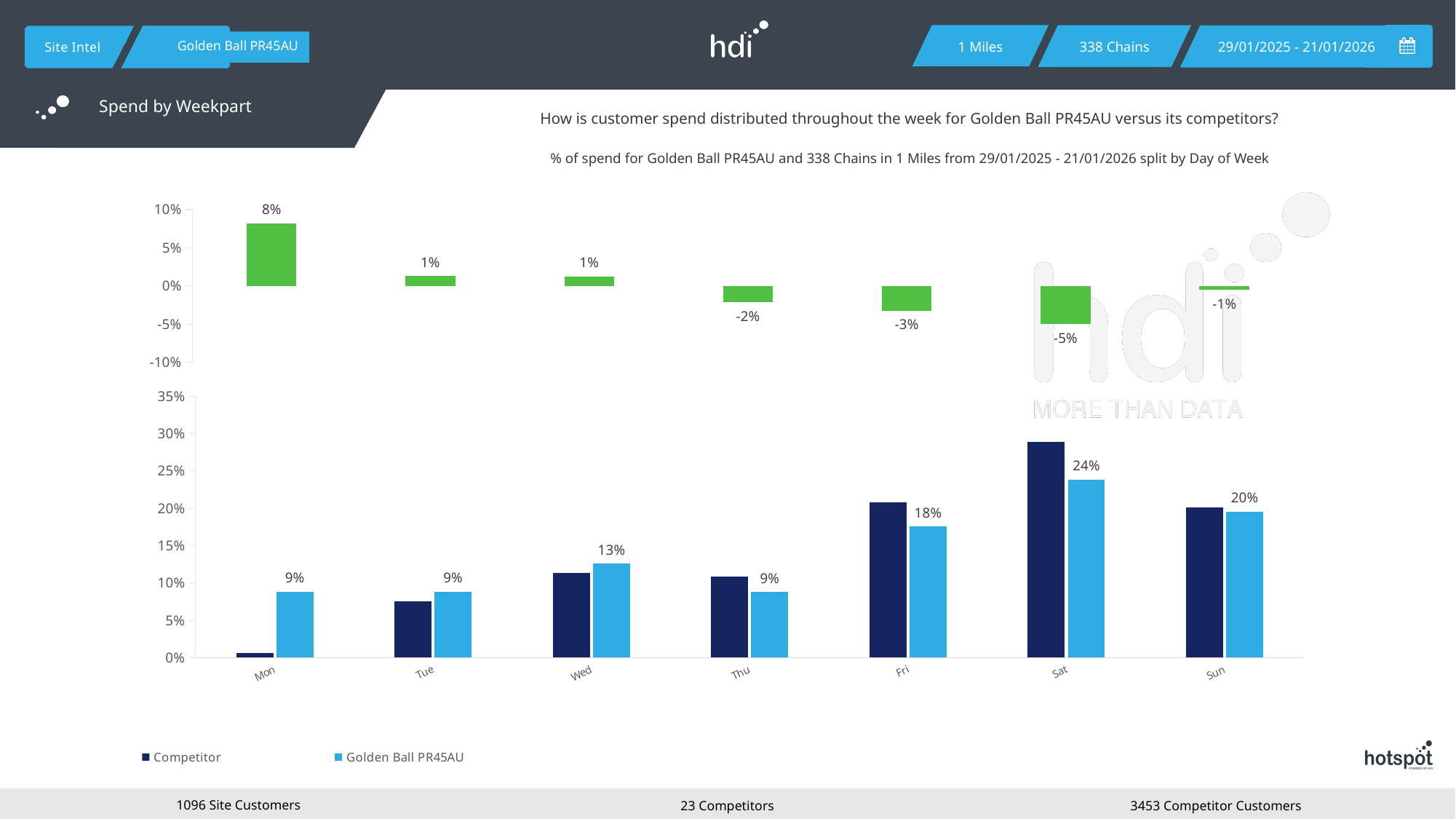
In the bottom chart, which is larger on Mon: the Competitor bar or the Golden Ball PR45AU bar? Golden Ball PR45AU In the bottom chart, is the Competitor value for Sat greater or less than 25%? greater In the top chart, what is the value shown for Mon? 8% In the bottom chart, what is the value for Golden Ball PR45AU on Wed? 13% In the top chart, what is the value shown for Sat? -5% In the bottom chart, on which day is the Golden Ball PR45AU value highest? Sat In the bottom chart, what is the difference between the Golden Ball PR45AU values for Sat and Fri? 6% In the top chart, which day has the lowest value? Sat What kind of chart is the bottom chart? Bar chart How many series does the legend of the bottom chart list? 2 In the bottom chart, what is the value for Golden Ball PR45AU on Sat? 24% How many days of the week are shown on the x axis of the bottom chart? 7